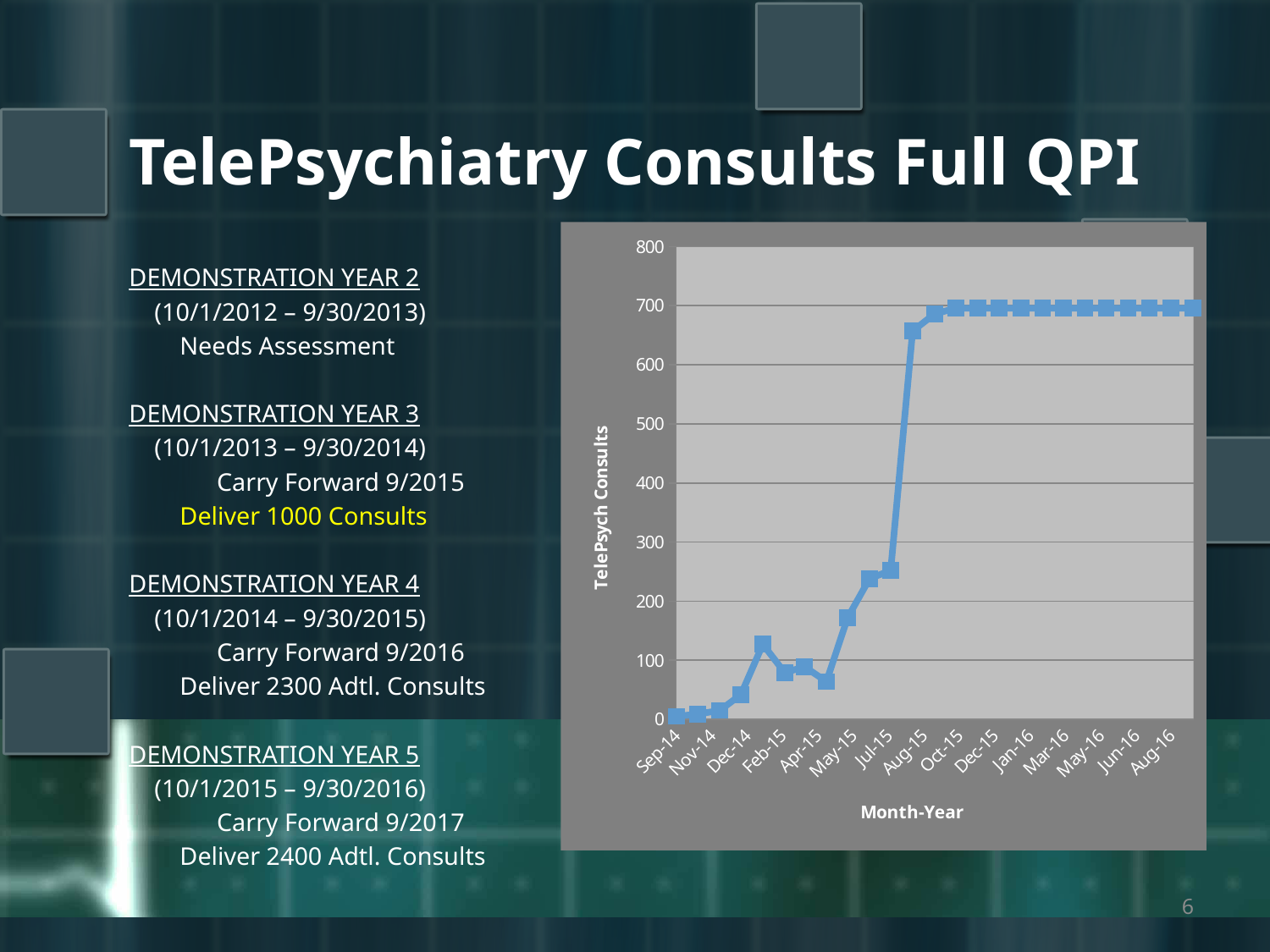
Is the value for Aug-15 greater or less than 600? greater Is the value for Jul-15 greater or less than 300? less Is the value for Sep-14 greater or less than 100? less What is the title of the horizontal axis of the chart? Month-Year What is the title of the vertical axis of the chart? TelePsych Consults Which is larger, the value for Aug-15 or the value for Jul-15? Aug-15 What kind of chart is shown on the slide? line chart How many month labels are shown on the horizontal axis? 15 Do the values generally rise or fall from Sep-14 to Aug-16? rise